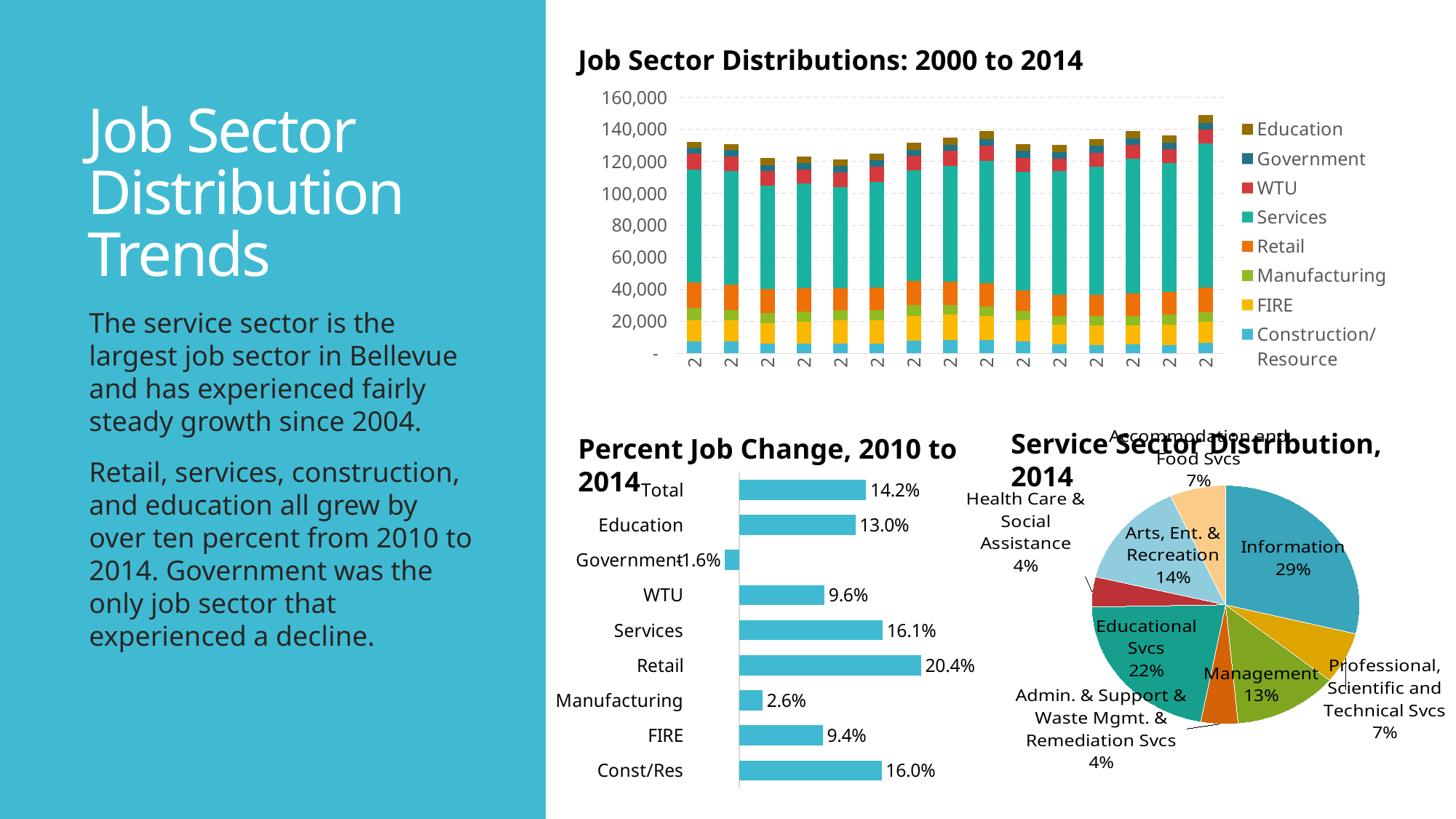
In the 'Percent Job Change, 2010 to 2014' chart, which category has the lowest value? Government In the 'Percent Job Change, 2010 to 2014' chart, what is the difference between the values for Retail and Services? 4.3% How many categories are shown in the 'Percent Job Change, 2010 to 2014' chart? 9 In the 'Job Sector Distributions: 2000 to 2014' chart, is the total of the rightmost bar greater or less than 140,000? greater In the 'Service Sector Distribution, 2014' pie chart, what share does Information have? 29% In the 'Percent Job Change, 2010 to 2014' chart, which is larger, the value for Education or the value for WTU? Education How many slices are in the 'Service Sector Distribution, 2014' pie chart? 8 In the 'Percent Job Change, 2010 to 2014' chart, what is the value for Retail? 20.4% In the 'Service Sector Distribution, 2014' pie chart, which slice is the largest? Information In the 'Percent Job Change, 2010 to 2014' chart, which category has the highest value? Retail In the 'Percent Job Change, 2010 to 2014' chart, what is the value for Government? -1.6% How many series does the legend of the 'Job Sector Distributions: 2000 to 2014' chart list? 8